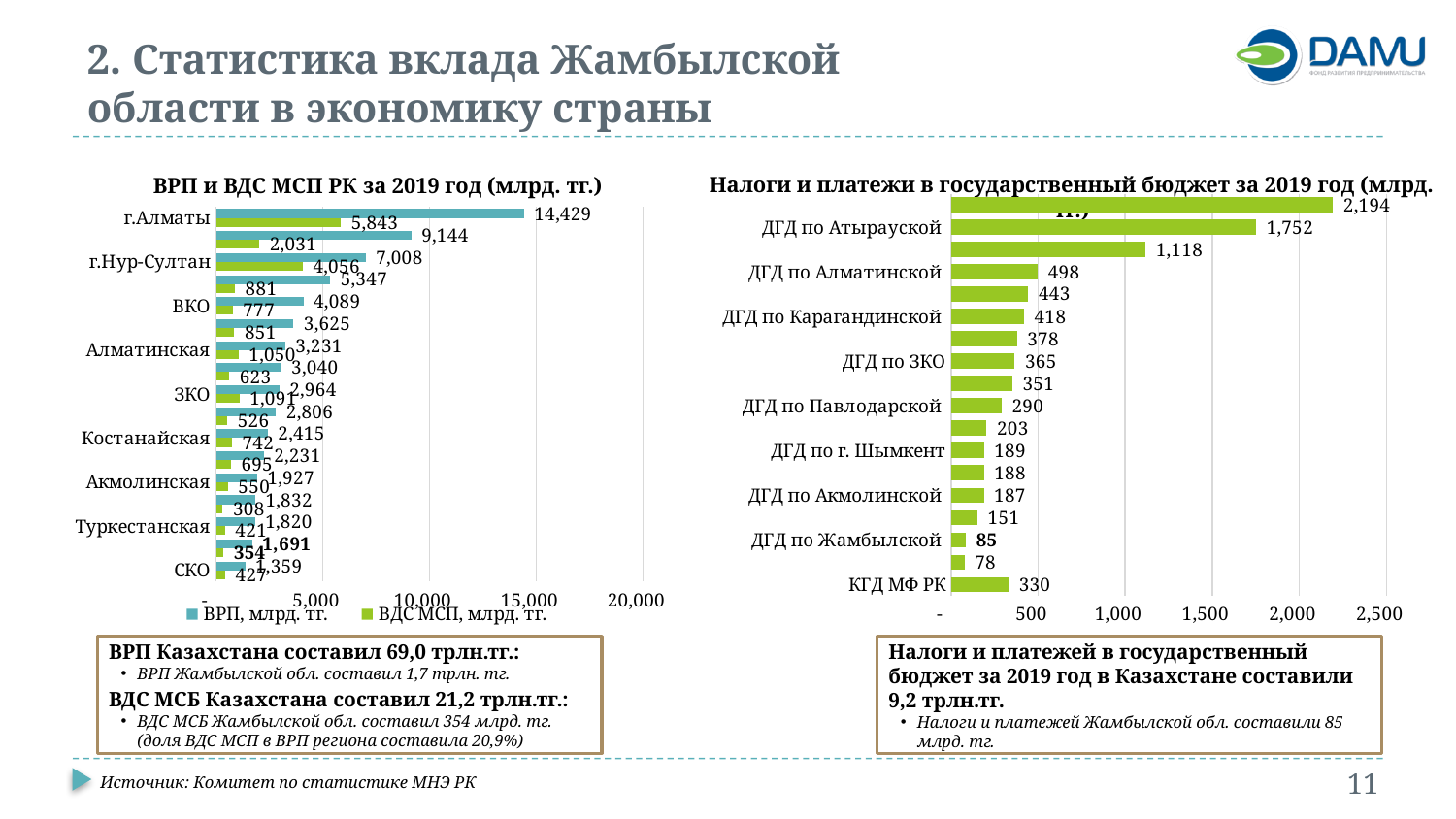
In the chart 'Налоги и платежи в государственный бюджет за 2019 год', which is larger: ДГД по ЗКО or ДГД по Павлодарской? ДГД по ЗКО In the chart 'Налоги и платежи в государственный бюджет за 2019 год', what is the value for ДГД по Карагандинской? 418 In the chart 'Налоги и платежи в государственный бюджет за 2019 год', what is the value for КГД МФ РК? 330 In the chart 'ВРП и ВДС МСП РК за 2019 год', which region has the highest ВРП? г.Алматы In the chart 'Налоги и платежи в государственный бюджет за 2019 год', is the value for ДГД по Алматинской greater or less than 1,000? less In the chart 'Налоги и платежи в государственный бюджет за 2019 год', what is the value for ДГД по Атырауской? 1,752 In the chart 'ВРП и ВДС МСП РК за 2019 год', what is the ВДС МСП value for г.Нур-Султан? 4,056 In the chart 'Налоги и платежи в государственный бюджет за 2019 год', what is the difference between the values for ДГД по Атырауской and ДГД по Алматинской? 1,254 In the chart 'ВРП и ВДС МСП РК за 2019 год', how many series does the legend list? 2 In the chart 'ВРП и ВДС МСП РК за 2019 год', what is the difference between the ВРП values for г.Алматы and г.Нур-Султан? 7,421 In the chart 'Налоги и платежи в государственный бюджет за 2019 год', what is the value for ДГД по Жамбылской? 85 In the chart 'ВРП и ВДС МСП РК за 2019 год', what is the ВРП value for г.Алматы? 14,429